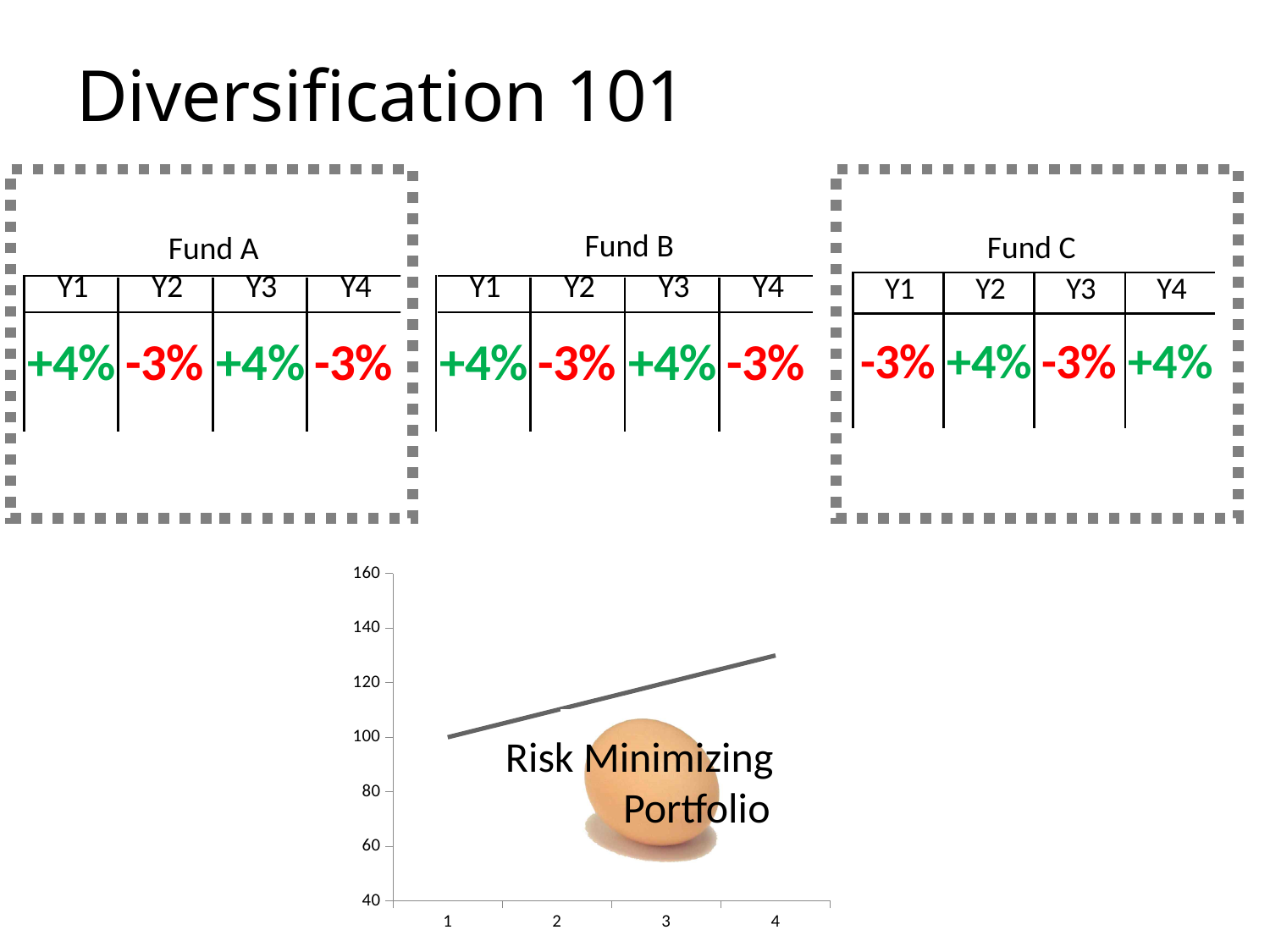
In the line chart, is the value at x = 1 greater or less than 120? less What text label is placed on the line chart? Risk Minimizing Portfolio How many points are plotted along the x axis of the line chart? 4 In the line chart, which x value has the highest plotted value? 4 In the line chart, do the values rise or fall as the x axis goes from 1 to 4? rise What is the highest value shown on the y axis of the line chart? 160 In the line chart, which x value has the lowest plotted value? 1 In the line chart, is the value at x = 4 greater or less than 140? less In the line chart, is the value at x = 2 greater or less than 100? greater What kind of chart is shown at the bottom of the slide? line chart In the line chart, which is larger: the value at x = 4 or the value at x = 1? x = 4